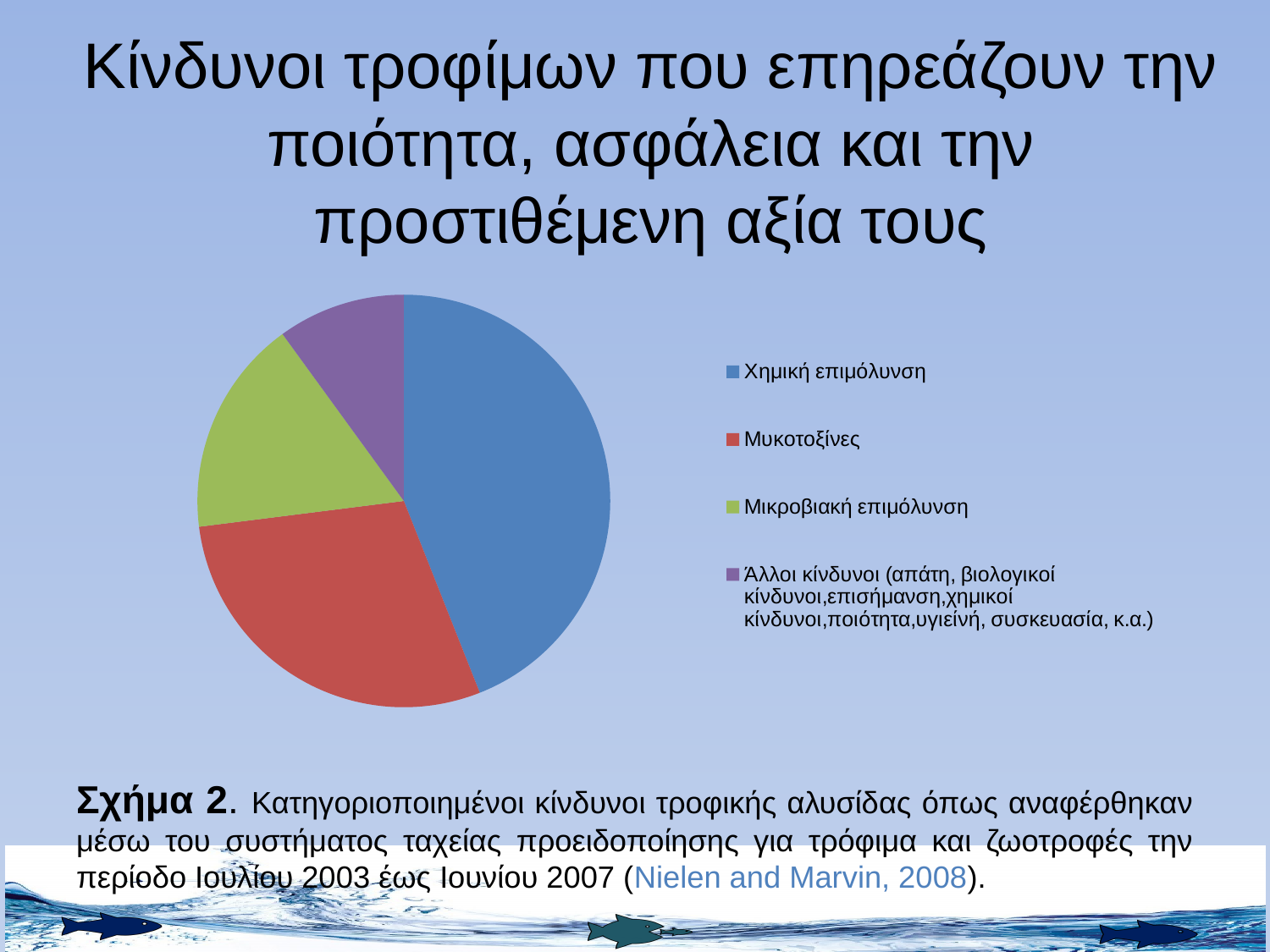
How many slices does the pie chart have? 4 Which category is the second largest slice of the pie chart? Μυκοτοξίνες How many entries does the legend of the pie chart list? 4 Which category has the largest slice of the pie chart? Χημική επιμόλυνση Which slice is larger, Μυκοτοξίνες or Μικροβιακή επιμόλυνση? Μυκοτοξίνες What colour is the slice for Μικροβιακή επιμόλυνση in the pie chart? green What colour is the slice for Χημική επιμόλυνση in the pie chart? blue Which category has the smallest slice of the pie chart? Άλλοι κίνδυνοι (απάτη, βιολογικοί κίνδυνοι,επισήμανση,χημικοί κίνδυνοι,ποιότητα,υγιεινή, συσκευασία, κ.α.) Which slice is larger, Μικροβιακή επιμόλυνση or Άλλοι κίνδυνοι? Μικροβιακή επιμόλυνση What kind of chart is shown on the slide? pie chart Which slice is larger, Χημική επιμόλυνση or Μυκοτοξίνες? Χημική επιμόλυνση